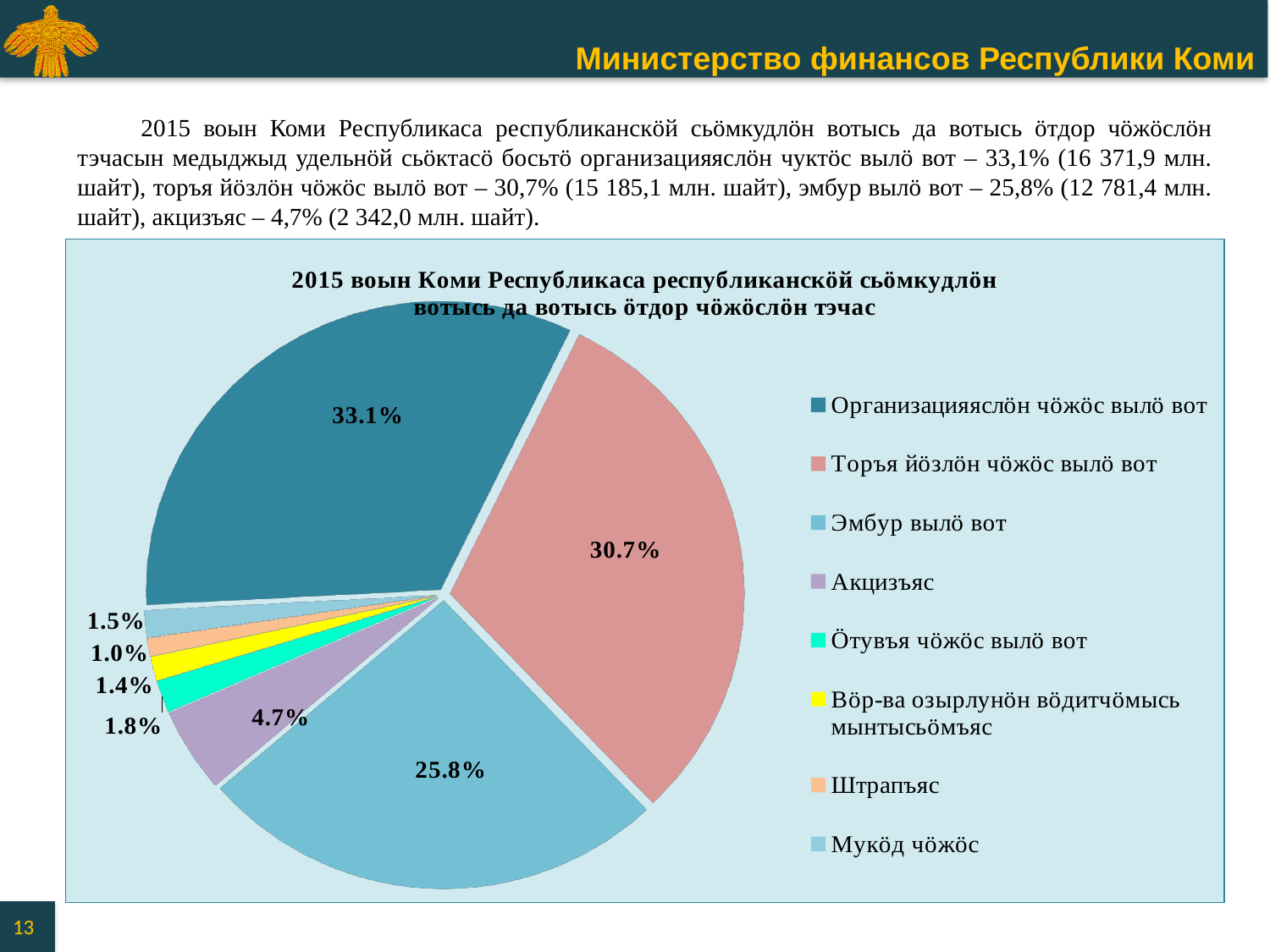
What share of the pie does Организацияяслӧн чӧжӧс вылӧ вот have? 33.1% What is the difference in percentage points between Организацияяслӧн чӧжӧс вылӧ вот and Торъя йӧзлӧн чӧжӧс вылӧ вот? 2.4 What kind of chart is shown on the slide? pie chart What colour is the slice for Ӧтувъя чӧжӧс вылӧ вот? green How many categories does the legend list? 8 What share of the pie does Штрапъяс have? 1.0% What share of the pie does Эмбур вылӧ вот have? 25.8% Which category has the smallest slice of the pie? Штрапъяс What share of the pie does Торъя йӧзлӧн чӧжӧс вылӧ вот have? 30.7% Which category has the largest slice of the pie? Организацияяслӧн чӧжӧс вылӧ вот What share of the pie does Акцизъяс have? 4.7% Which is larger: the slice for Эмбур вылӧ вот or the slice for Акцизъяс? Эмбур вылӧ вот